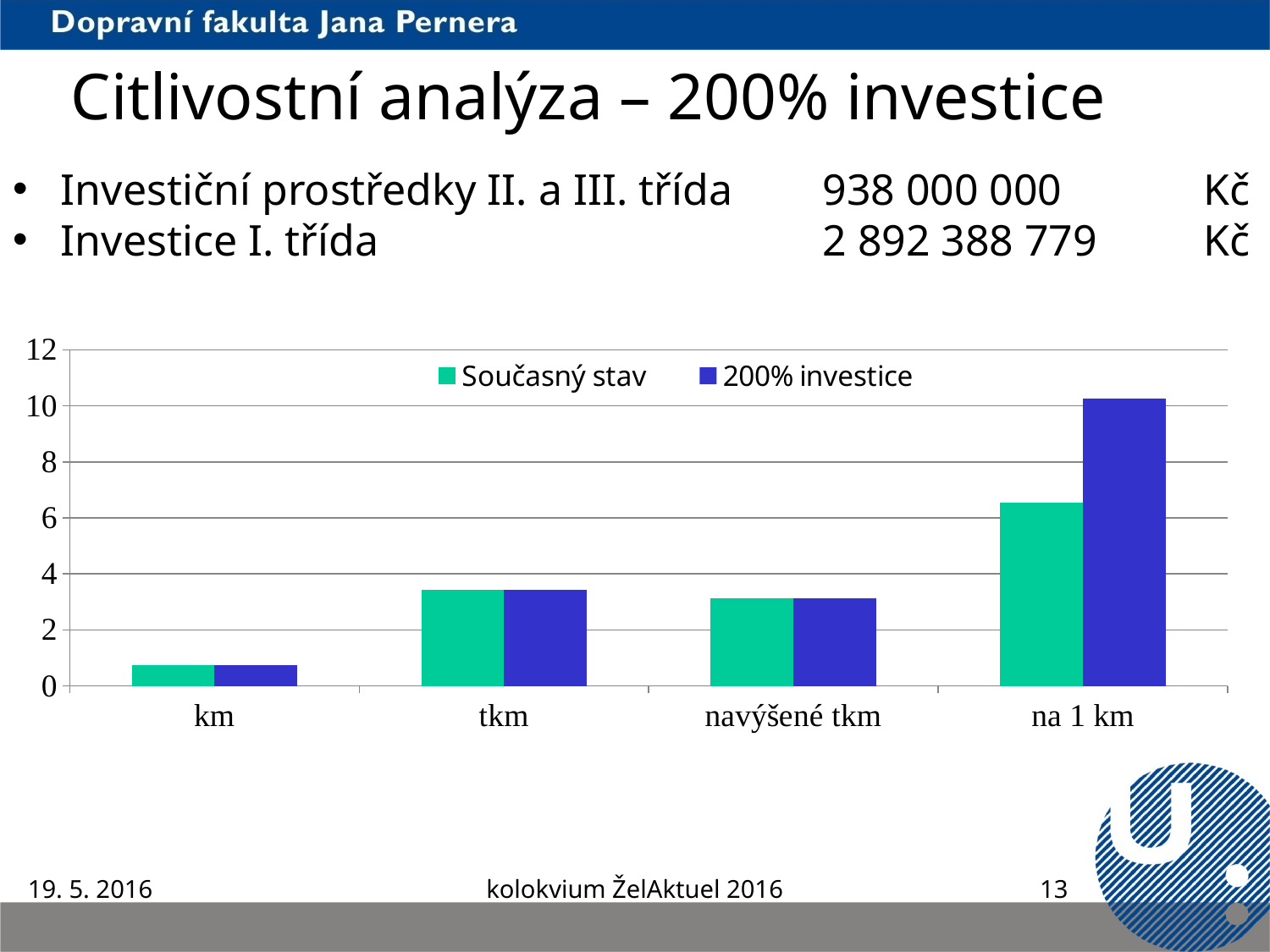
Is the value for Současný stav in the na 1 km category greater or less than 6? greater Is the value for 200% investice in the na 1 km category greater or less than 10? greater Which category has the lowest value for the Současný stav series? km How many series does the chart legend list? 2 Is the value for Současný stav in the km category greater or less than 2? less What are the two series named in the chart legend? Současný stav and 200% investice How many categories are shown on the x axis of the chart? 4 Which category has the highest value for the 200% investice series? na 1 km In the na 1 km category, which series has the larger value, Současný stav or 200% investice? 200% investice Which series is shown in blue in the chart? 200% investice What kind of chart is shown on the slide? bar chart